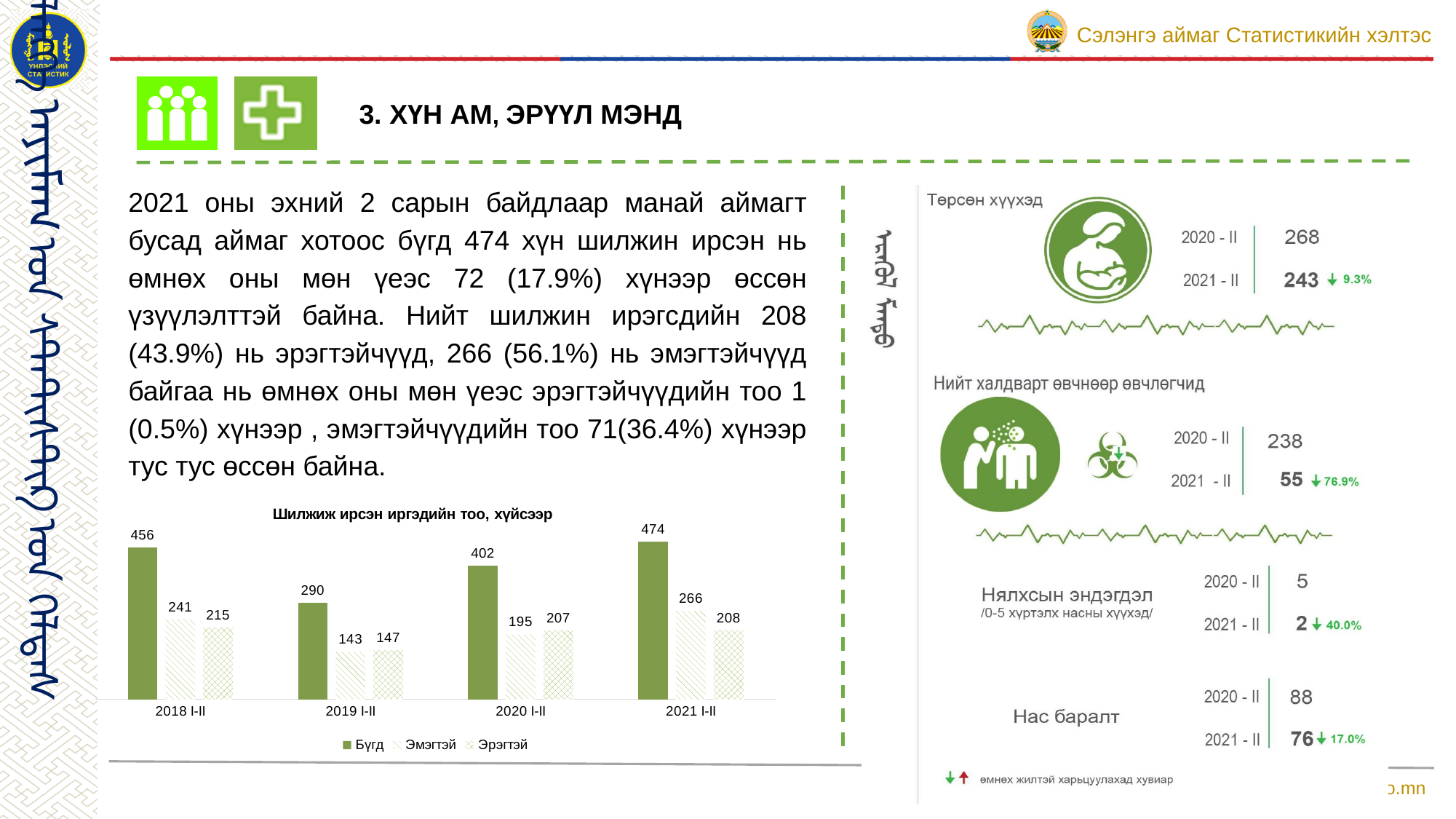
What is the title of the chart? Шилжиж ирсэн иргэдийн тоо, хүйсээр Which is larger in 2018 I-II, Эмэгтэй or Эрэгтэй? Эмэгтэй What is the value for Эмэгтэй in 2019 I-II? 143 What is the value for Бүгд in 2021 I-II? 474 What is the difference between the Бүгд values for 2021 I-II and 2020 I-II? 72 What is the value for Эрэгтэй in 2020 I-II? 207 Which year has the lowest value for Бүгд? 2019 I-II How many year categories are shown on the x axis? 4 Does the Бүгд value rise or fall from 2019 I-II to 2021 I-II? Rise Which year has the highest value for Эмэгтэй? 2021 I-II How many series does the legend list? 3 What kind of chart is shown? Bar chart